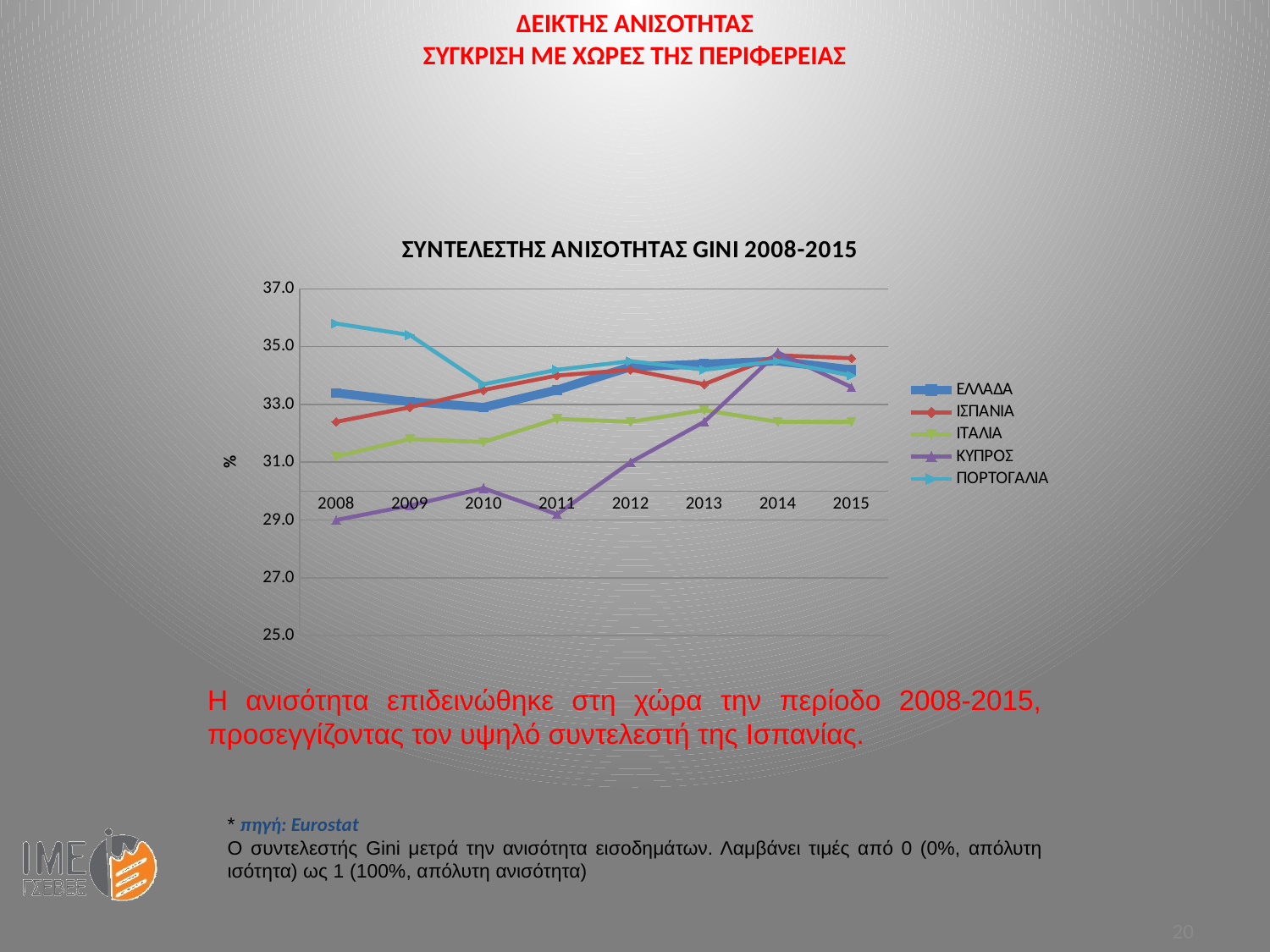
What kind of chart is shown on the slide? line chart Does the value for ΚΥΠΡΟΣ rise or fall overall from 2008 to 2015? rise Which is larger in 2008, the value for ΠΟΡΤΟΓΑΛΙΑ or the value for ΙΤΑΛΙΑ? ΠΟΡΤΟΓΑΛΙΑ What is the label on the vertical axis? % Which country has the lowest value in 2015? ΙΤΑΛΙΑ What is the title of the chart? ΣΥΝΤΕΛΕΣΤΗΣ ΑΝΙΣΟΤΗΤΑΣ GINI 2008-2015 Which country has the highest value in 2008? ΠΟΡΤΟΓΑΛΙΑ How many series does the legend list? 5 Is the value for ΠΟΡΤΟΓΑΛΙΑ in 2008 greater or less than 35.0? greater Is the value for ΚΥΠΡΟΣ in 2010 greater or less than 31.0? less How many years are plotted along the x axis? 8 Which country has the lowest value in 2008? ΚΥΠΡΟΣ